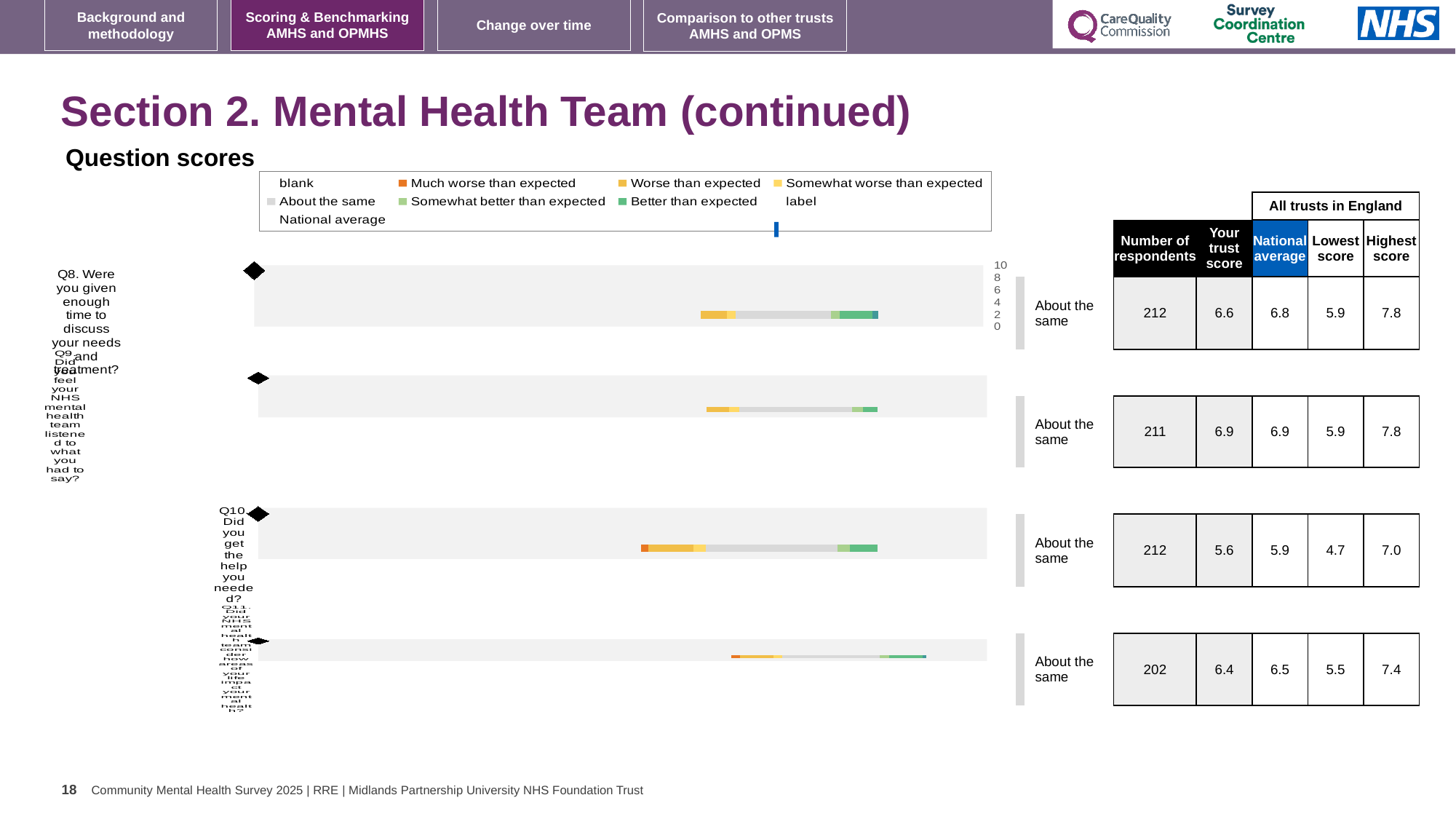
In the legend, which colour represents 'Better than expected'? green How many respondents answered Q11? 202 What is the difference between the national average and the trust score for Q8? 0.2 Which question has the highest trust score? Q9 How many survey questions (Q8 to Q11) have a bar chart on the slide? 4 What is the trust score for Q8 (Were you given enough time to discuss your needs and treatment?)? 6.6 In the legend, which colour represents 'Much worse than expected'? orange What kind of chart is used to show the question scores for Q8 to Q11? bar chart Is the trust score for Q9 larger or smaller than the trust score for Q10? larger What is the difference between the highest score and the lowest score for Q10? 2.3 Which question has the lowest trust score? Q10 What is the national average score for Q10 (Did you get the help you needed?)? 5.9